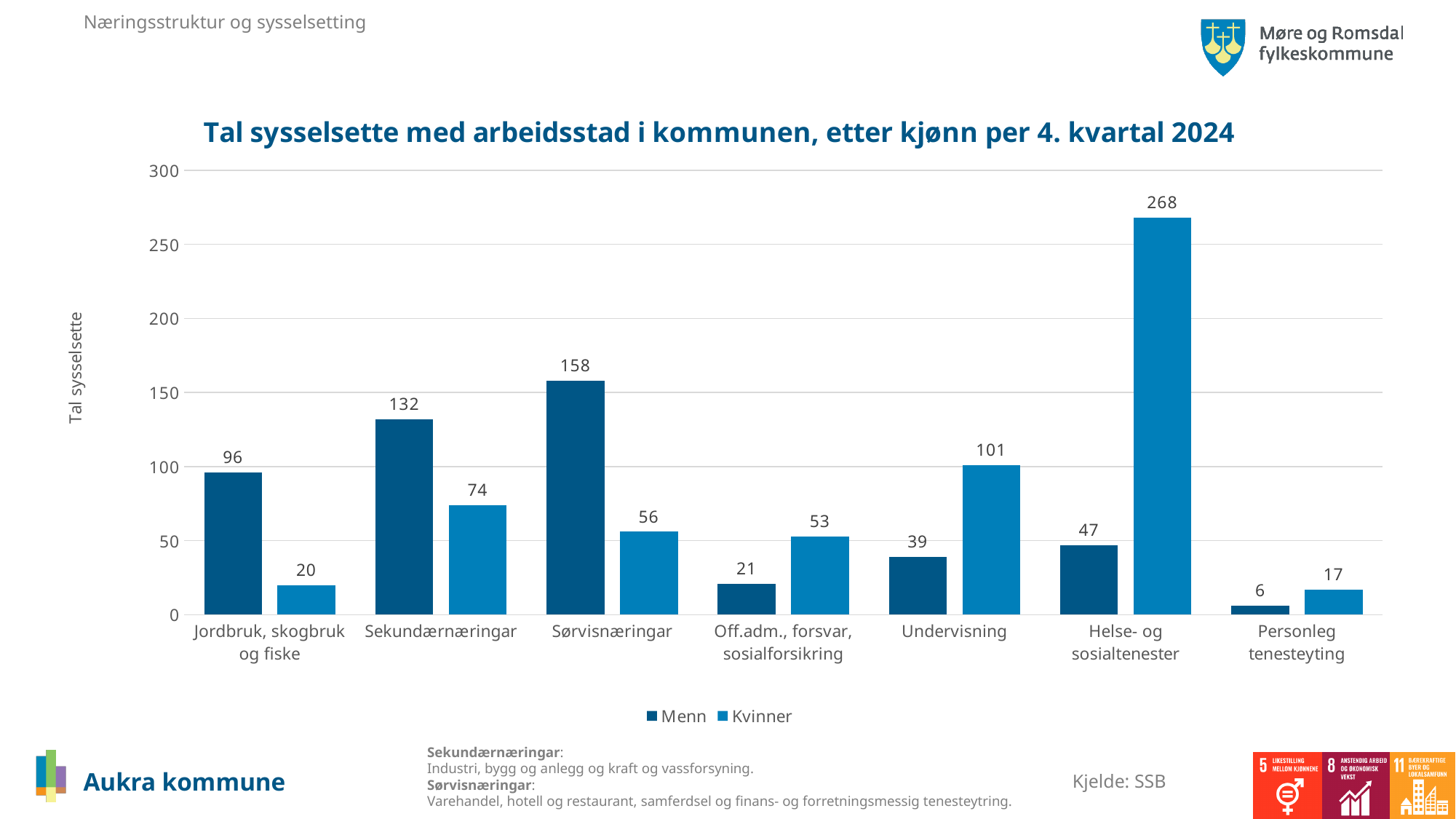
Which category has the highest value for Menn? Sørvisnæringar What is the total of Menn and Kvinner in Sekundærnæringar? 206 Which category has the lowest value for Kvinner? Personleg tenesteyting What is the difference between Menn and Kvinner in Jordbruk, skogbruk og fiske? 76 How many series does the legend list? 2 How many categories are shown on the x axis? 7 Which is larger in Off.adm., forsvar, sosialforsikring: Menn or Kvinner? Kvinner What kind of chart is shown? bar chart What is the value for Kvinner in Undervisning? 101 Is the value for Kvinner in Helse- og sosialtenester greater or less than 250? greater What is the value for Menn in Sørvisnæringar? 158 What is the value for Kvinner in Helse- og sosialtenester? 268